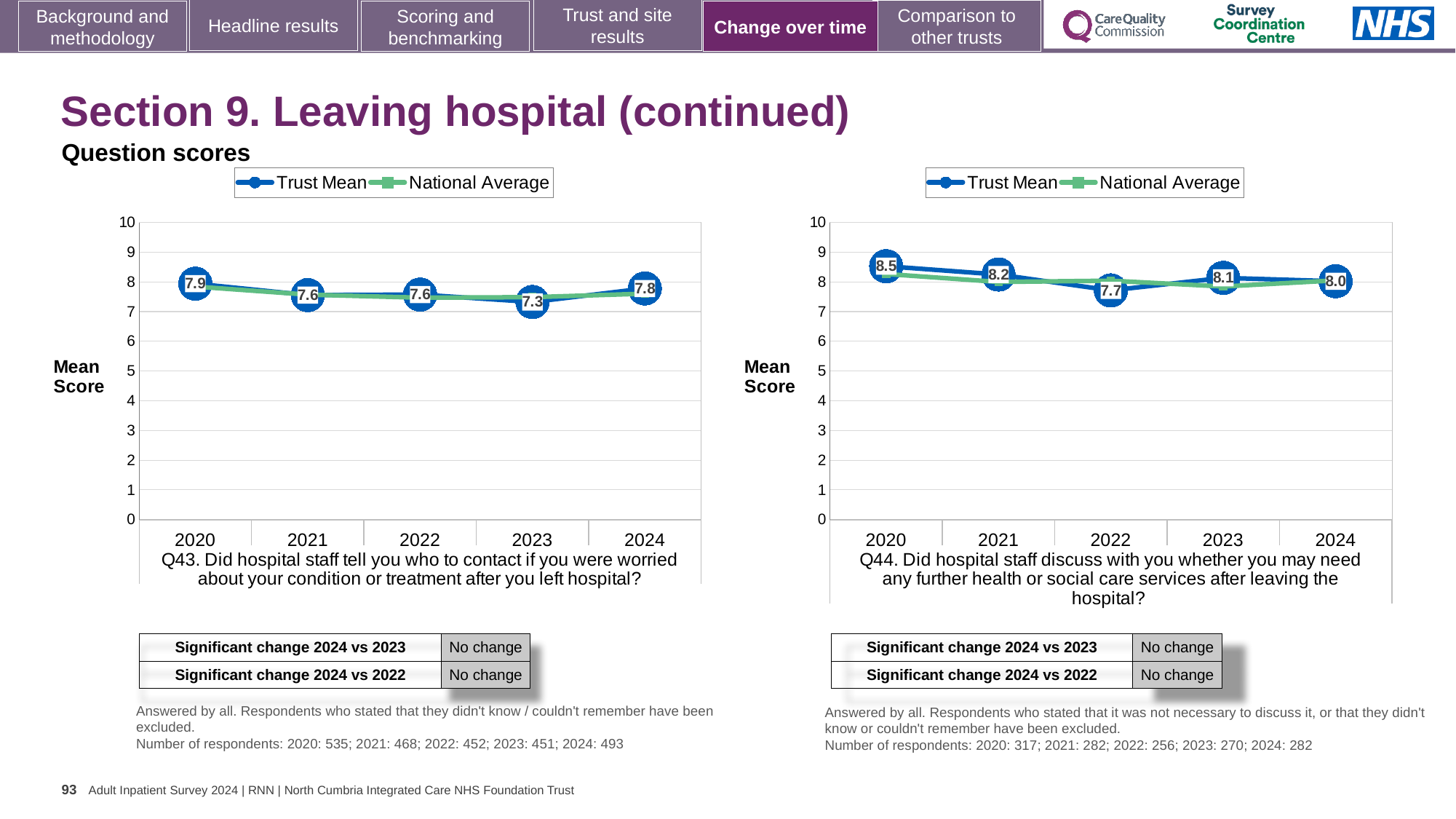
In the Q44 chart (right), which year has the highest Trust Mean score? 2020 In the Q44 chart (right), what is the Trust Mean score for 2022? 7.7 How many years are plotted on the x axis of the Q43 chart (left)? 5 How many series does the legend of the Q44 chart (right) list? 2 In the Q43 chart (left), what is the Trust Mean score for 2023? 7.3 What kind of chart is the Q43 chart (left)? Line chart In the Q44 chart (right), what is the Trust Mean score for 2020? 8.5 In the Q44 chart (right), is the Trust Mean score for 2021 or 2024 larger? 2021 In the Q43 chart (left), which year has the lowest Trust Mean score? 2023 In the Q43 chart (left), what is the Trust Mean score for 2020? 7.9 In the Q44 chart (right), what is the difference between the Trust Mean scores for 2020 and 2022? 0.8 In the Q43 chart (left), what is the difference between the Trust Mean scores for 2020 and 2023? 0.6